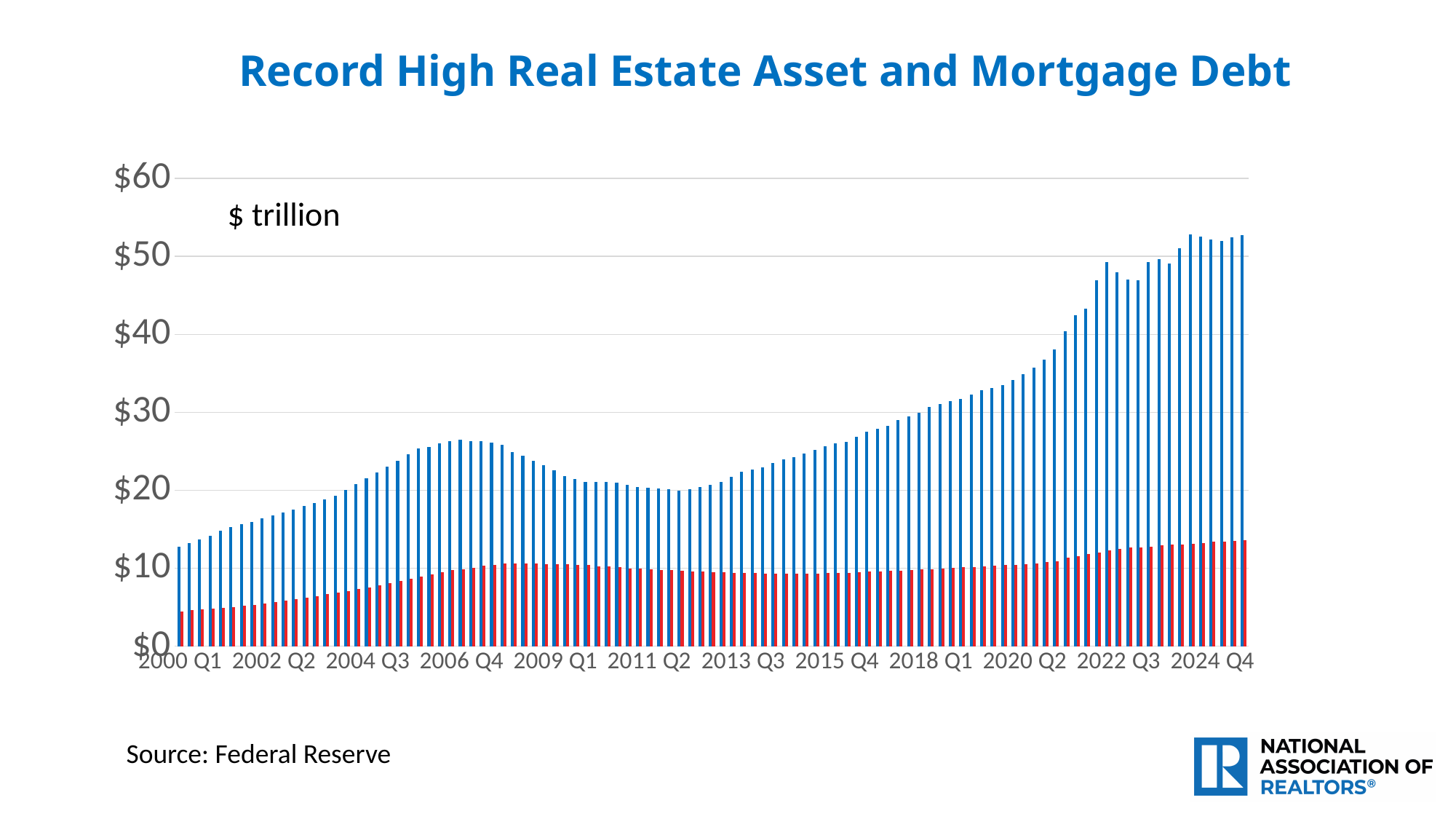
What kind of chart is shown on the slide? bar chart Which is larger, the blue bar at 2006 Q4 or the blue bar at 2011 Q2? 2006 Q4 Is the value of the red bar at 2000 Q1 greater or less than $10? less Is the value of the red bar at 2024 Q4 greater or less than $10? greater Overall, do the blue bars rise or fall from 2000 Q1 to 2024 Q4? rise Is the value of the blue bar at 2020 Q2 greater or less than $30? greater Among the labelled quarters on the x axis, which has the lowest blue bar? 2000 Q1 What unit is the chart's vertical axis measured in, as labelled on the chart? $ trillion What is the title of the chart? Record High Real Estate Asset and Mortgage Debt